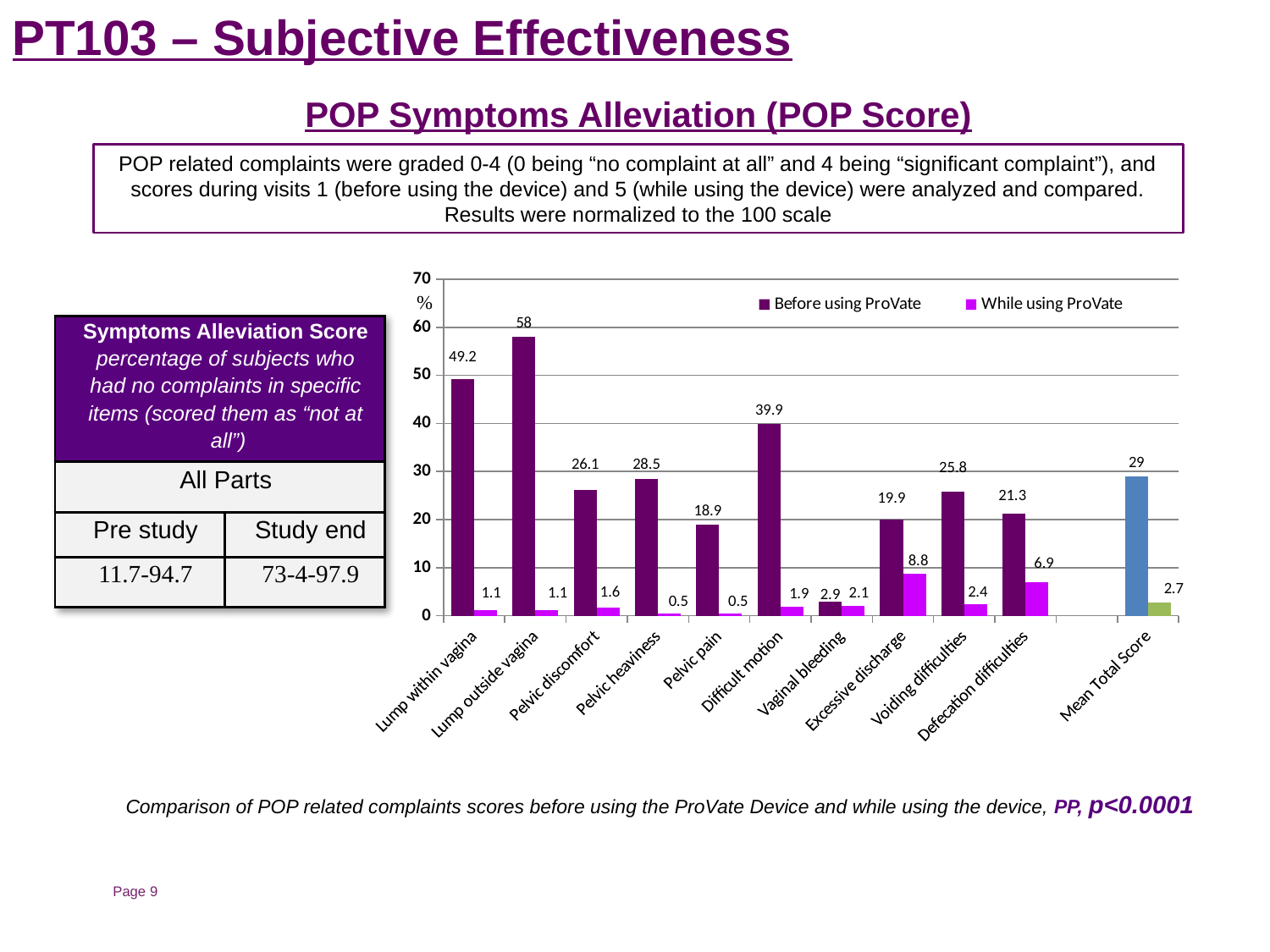
How many categories are shown on the x axis of the chart? 11 Which category has the highest Before using ProVate value? Lump outside vagina What kind of chart is shown on the slide? bar chart What is the value for Lump outside vagina in the Before using ProVate series? 58 What are the two series named in the chart legend? Before using ProVate and While using ProVate How many series does the chart legend list? 2 Which category has the lowest Before using ProVate value? Vaginal bleeding Is the Before using ProVate value for Lump within vagina greater or less than 40? greater For Difficult motion, what is the difference between the Before using ProVate value and the While using ProVate value? 38 What is the value for Excessive discharge in the While using ProVate series? 8.8 What is the While using ProVate value for Mean Total Score? 2.7 In the Before using ProVate series, which is larger: Pelvic heaviness or Pelvic discomfort? Pelvic heaviness